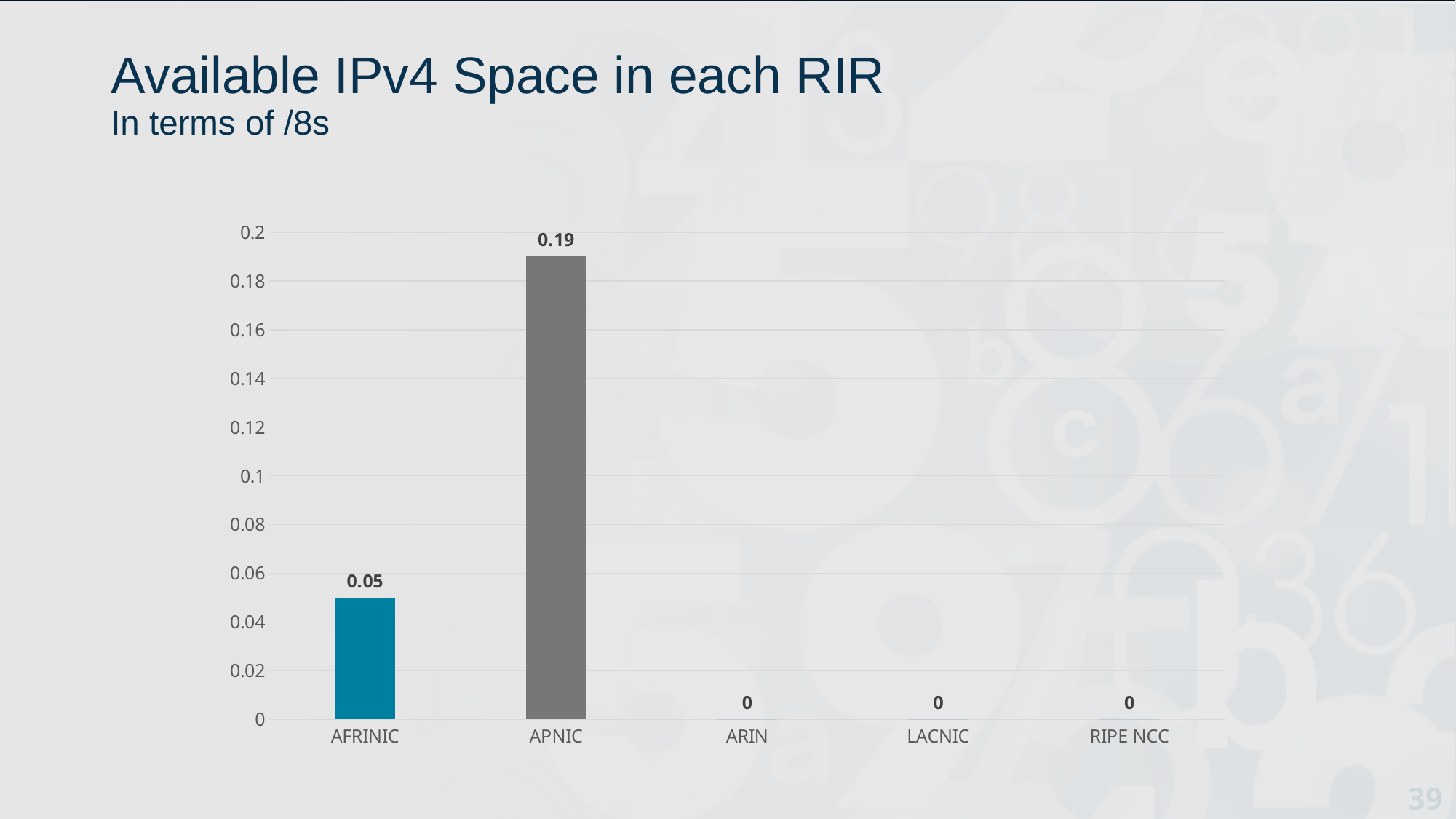
What kind of chart is shown on the slide? bar chart How many RIRs are shown on the x axis? 5 Which is larger, the value for AFRINIC or the value for APNIC? APNIC What is the value for AFRINIC? 0.05 Which RIR has the highest available IPv4 space? APNIC What is the title of the slide? Available IPv4 Space in each RIR What is the value for RIPE NCC? 0 What is the value for ARIN? 0 What is the value for APNIC? 0.19 Is the value for APNIC greater or less than 0.1? greater What is the difference between the values for APNIC and AFRINIC? 0.14 How many RIRs have a value of 0? 3